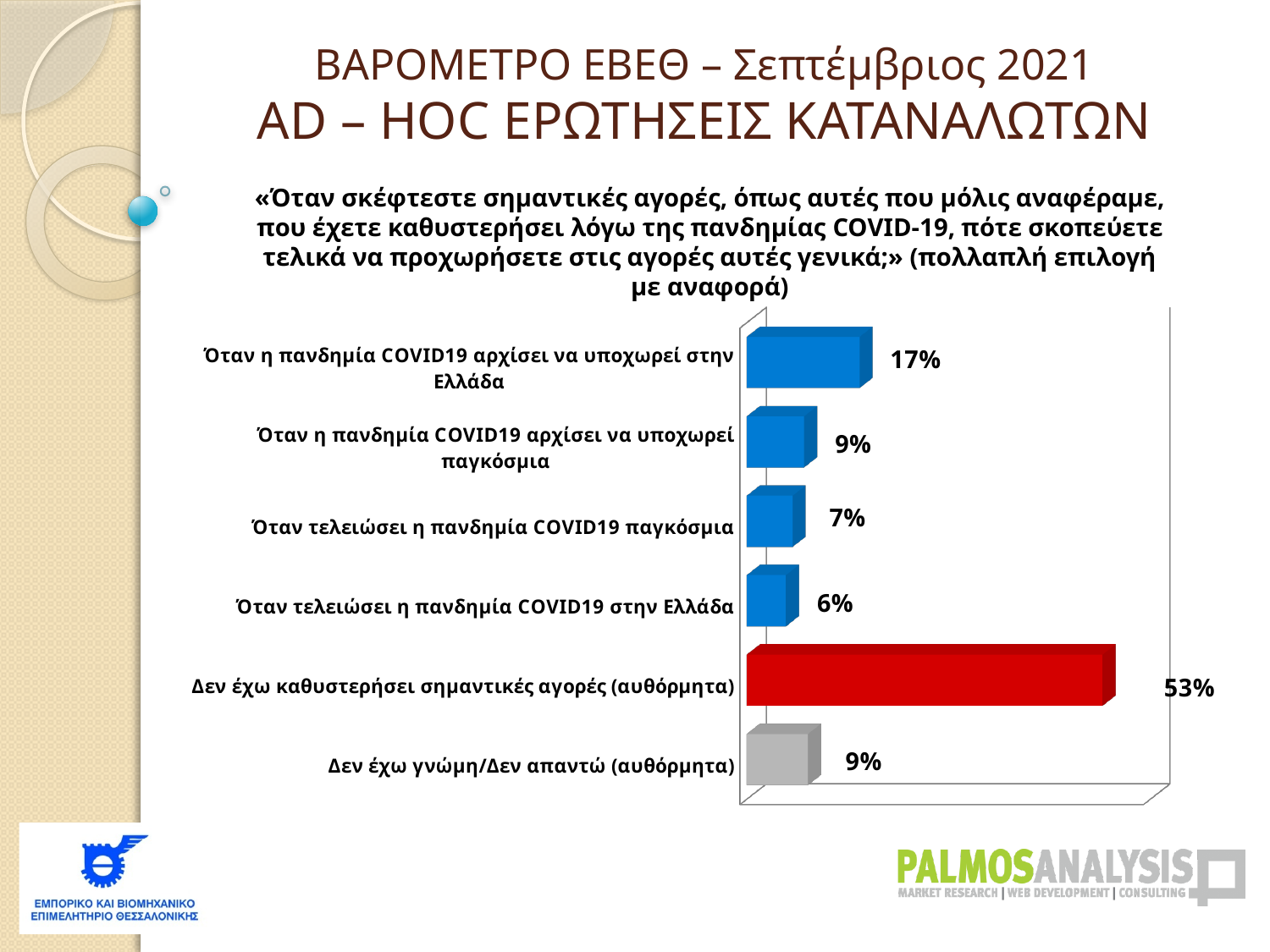
What percentage of respondents answered "Δεν έχω καθυστερήσει σημαντικές αγορές (αυθόρμητα)"? 53% Which category has the lowest value in the chart? Όταν τελειώσει η πανδημία COVID19 στην Ελλάδα How many categories are shown in the chart? 6 What is the value for "Όταν τελειώσει η πανδημία COVID19 παγκόσμια"? 7% What is the value for "Όταν τελειώσει η πανδημία COVID19 στην Ελλάδα"? 6% What colour is the bar for "Δεν έχω γνώμη/Δεν απαντώ (αυθόρμητα)"? Grey Which is larger: the value for "Όταν η πανδημία COVID19 αρχίσει να υποχωρεί παγκόσμια" or the value for "Όταν τελειώσει η πανδημία COVID19 παγκόσμια"? Όταν η πανδημία COVID19 αρχίσει να υποχωρεί παγκόσμια What kind of chart is shown on the slide? Bar chart What colour is the bar for "Δεν έχω καθυστερήσει σημαντικές αγορές (αυθόρμητα)"? Red What is the value for "Όταν η πανδημία COVID19 αρχίσει να υποχωρεί στην Ελλάδα"? 17% What is the difference between the value for "Δεν έχω καθυστερήσει σημαντικές αγορές (αυθόρμητα)" and the value for "Όταν η πανδημία COVID19 αρχίσει να υποχωρεί στην Ελλάδα"? 36% Which category has the highest value in the chart? Δεν έχω καθυστερήσει σημαντικές αγορές (αυθόρμητα)